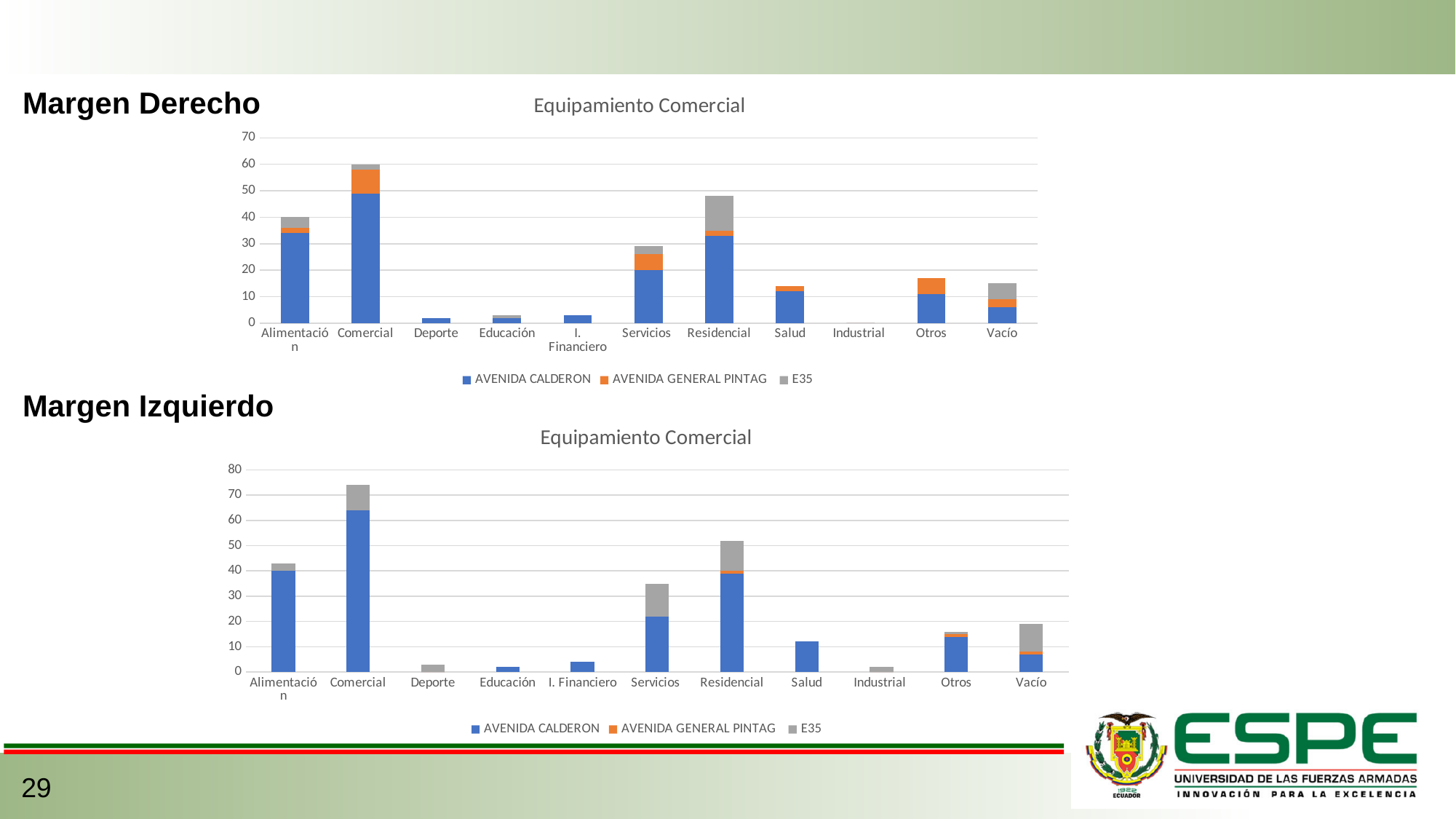
In the top chart under 'Margen Derecho', is the total for Salud greater or less than 20? less In the top chart under 'Margen Derecho', which category has the tallest stacked bar? Comercial In the top chart under 'Margen Derecho', which category has the lowest total? Industrial In the top chart under 'Margen Derecho', which has the larger total, Residencial or Alimentación? Residencial In the bottom chart under 'Margen Izquierdo', which has the larger total, Servicios or Vacío? Servicios What are the three legend entries of the bottom chart under 'Margen Izquierdo'? AVENIDA CALDERON, AVENIDA GENERAL PINTAG, E35 How many series does the legend of the top chart under 'Margen Derecho' list? 3 How many categories are shown on the x axis of the bottom chart under 'Margen Izquierdo'? 11 In the bottom chart under 'Margen Izquierdo', is the total for Comercial greater or less than 60? greater In the bottom chart under 'Margen Izquierdo', which category has the tallest stacked bar? Comercial What type of chart is the top chart under 'Margen Derecho'? Stacked bar chart In the top chart under 'Margen Derecho', is the total for Comercial greater or less than 50? greater